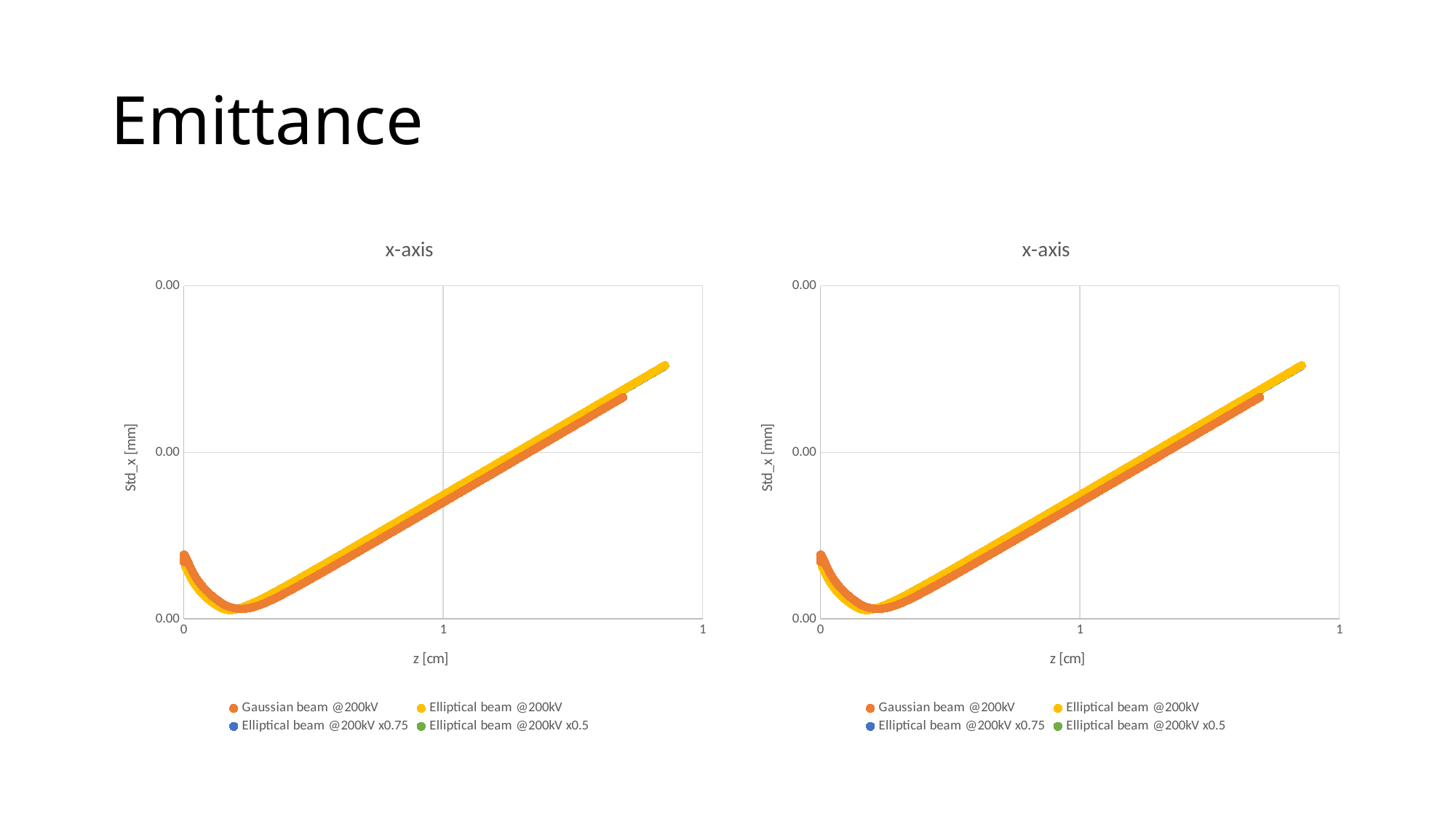
What kind of chart is the right chart on the slide? scatter chart How many series does the legend of the right chart list? 4 In the right chart, which series reaches a higher Std_x value at its right-hand end, Gaussian beam @200kV or Elliptical beam @200kV? Elliptical beam @200kV What kind of chart is the left chart on the slide? scatter chart What is the label of the horizontal axis on the right chart? z [cm] How many charts are shown on the slide? 2 In the right chart, do the plotted Std_x values rise or fall along the z axis after their initial dip near z = 0? rise In the left chart, which series reaches a higher Std_x value at its right-hand end, Gaussian beam @200kV or Elliptical beam @200kV? Elliptical beam @200kV In the left chart, do the plotted Std_x values rise or fall along the z axis after their initial dip near z = 0? rise How many series does the legend of the left chart list? 4 What is the title of the left chart? x-axis